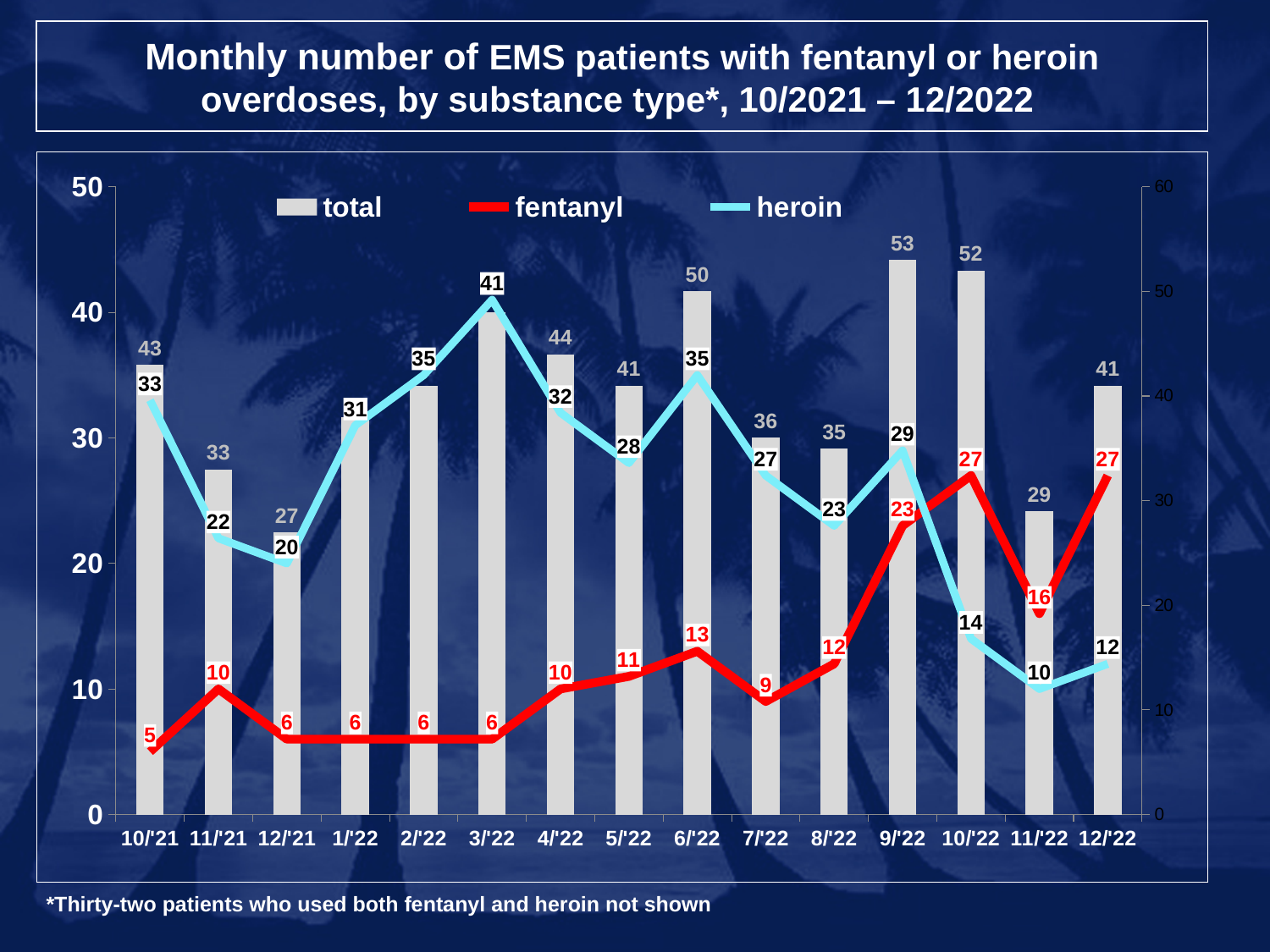
What is the heroin value for 3/'22? 41 What is the fentanyl value for 10/'22? 27 What is the difference between the fentanyl values for 12/'22 and 11/'22? 11 Which month has the lowest heroin value? 11/'22 How many series does the legend list? 3 How many months are shown on the x axis? 15 What is the total number of EMS patients shown for 9/'22? 53 Does the heroin line rise or fall from 9/'22 to 11/'22? fall Which month has the highest total bar? 9/'22 What kind of chart is this? Combined bar and line chart In 10/'22, which is larger, the fentanyl value or the heroin value? fentanyl According to the footnote, how many patients who used both fentanyl and heroin are not shown? Thirty-two